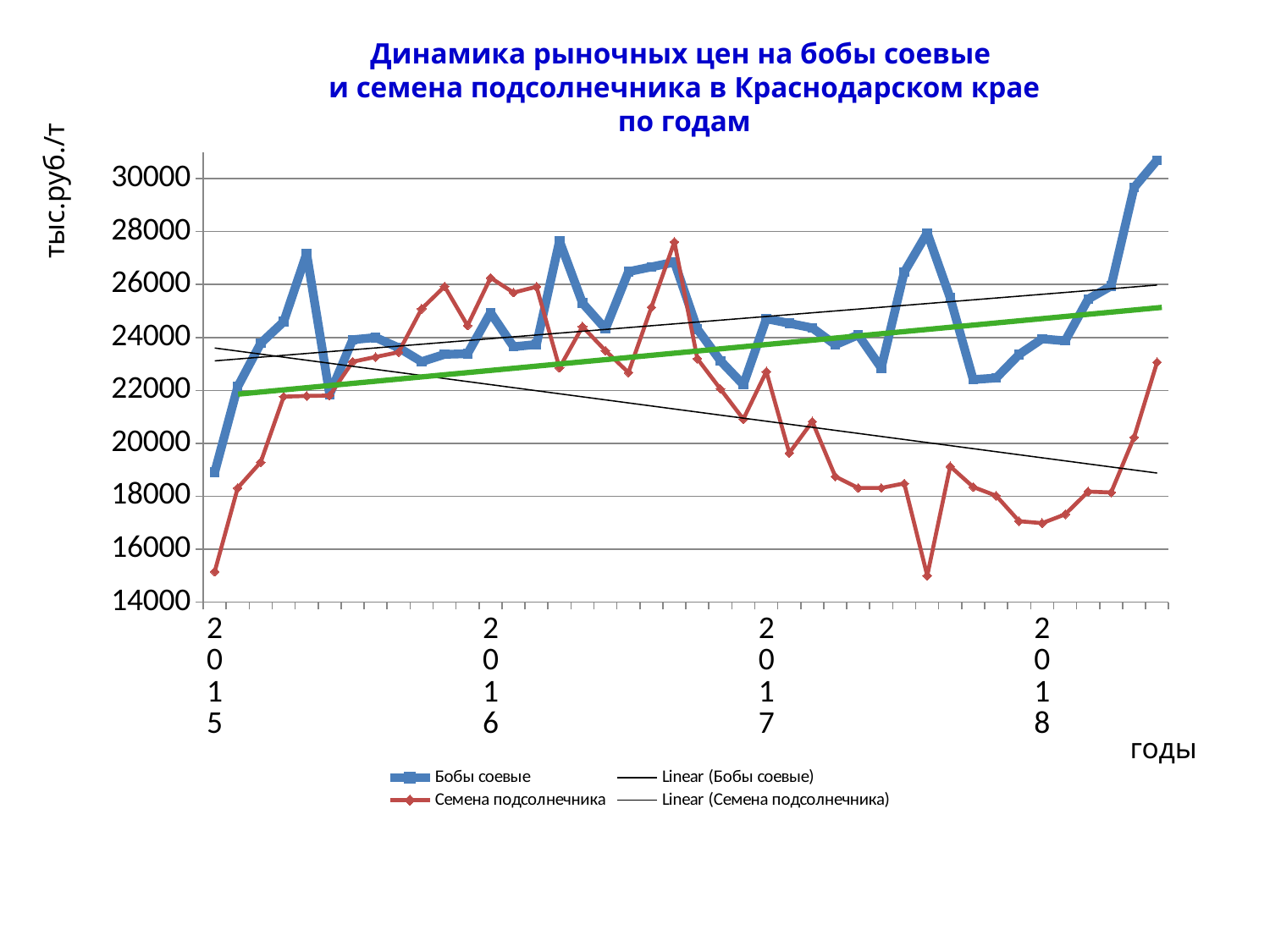
How many year labels are shown on the x axis? 4 Is the value for Бобы соевые at the start of 2015 greater or less than 20000? less Is the highest value reached by Бобы соевые greater or less than 30000? greater Does the linear trendline for Бобы соевые rise or fall across the years? rise Is the lowest value reached by Семена подсолнечника greater or less than 16000? less What kind of chart is shown on the slide? line chart At the start of 2015, which series has the higher value, Бобы соевые or Семена подсолнечника? Бобы соевые Does the linear trendline for Семена подсолнечника rise or fall across the years? fall What colour is the line for Бобы соевые? blue How many entries does the legend list? 4 What is the label of the vertical axis? тыс.руб./т